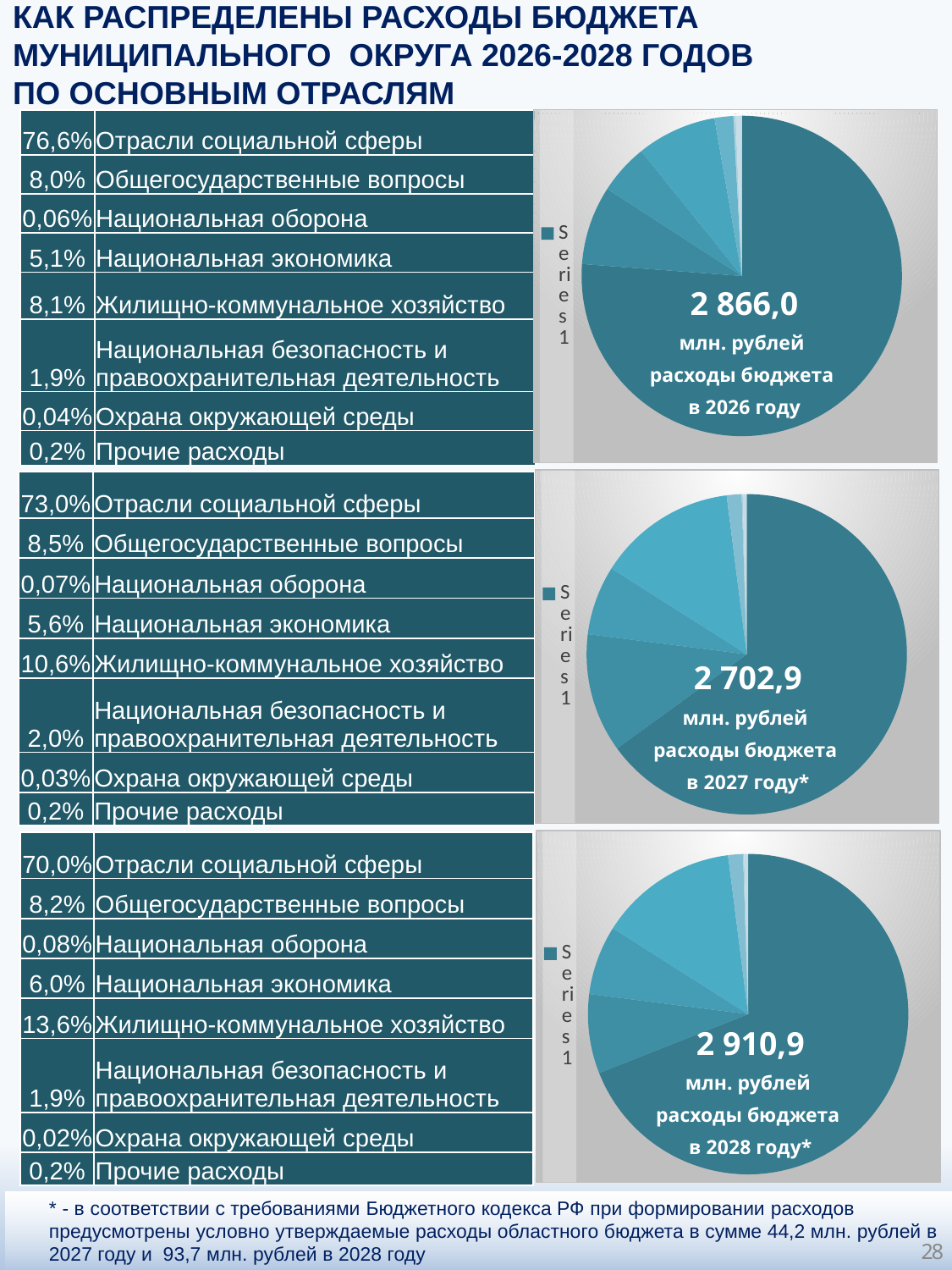
What total is printed in the centre of the pie chart for 2026? 2 866,0 млн. рублей How many pie charts are on the slide? 3 What share of the 2028 budget goes to Жилищно-коммунальное хозяйство according to the table next to the 2028 pie chart? 13,6% What legend entry is shown next to each pie chart? Series1 Is the share of Отрасли социальной сферы larger in the 2026 pie chart or the 2028 pie chart? 2026 What type of chart is used to show the 2026 budget expenditure distribution? pie chart What total is printed in the centre of the pie chart for 2027? 2 702,9 млн. рублей What total is printed in the centre of the pie chart for 2028? 2 910,9 млн. рублей What share of the 2026 budget goes to Отрасли социальной сферы according to the table next to the 2026 pie chart? 76,6% Which category has the largest slice in the 2027 pie chart? Отрасли социальной сферы Which year's pie chart shows the smallest total budget expenditure? 2027 Which year's pie chart shows the largest total budget expenditure? 2028